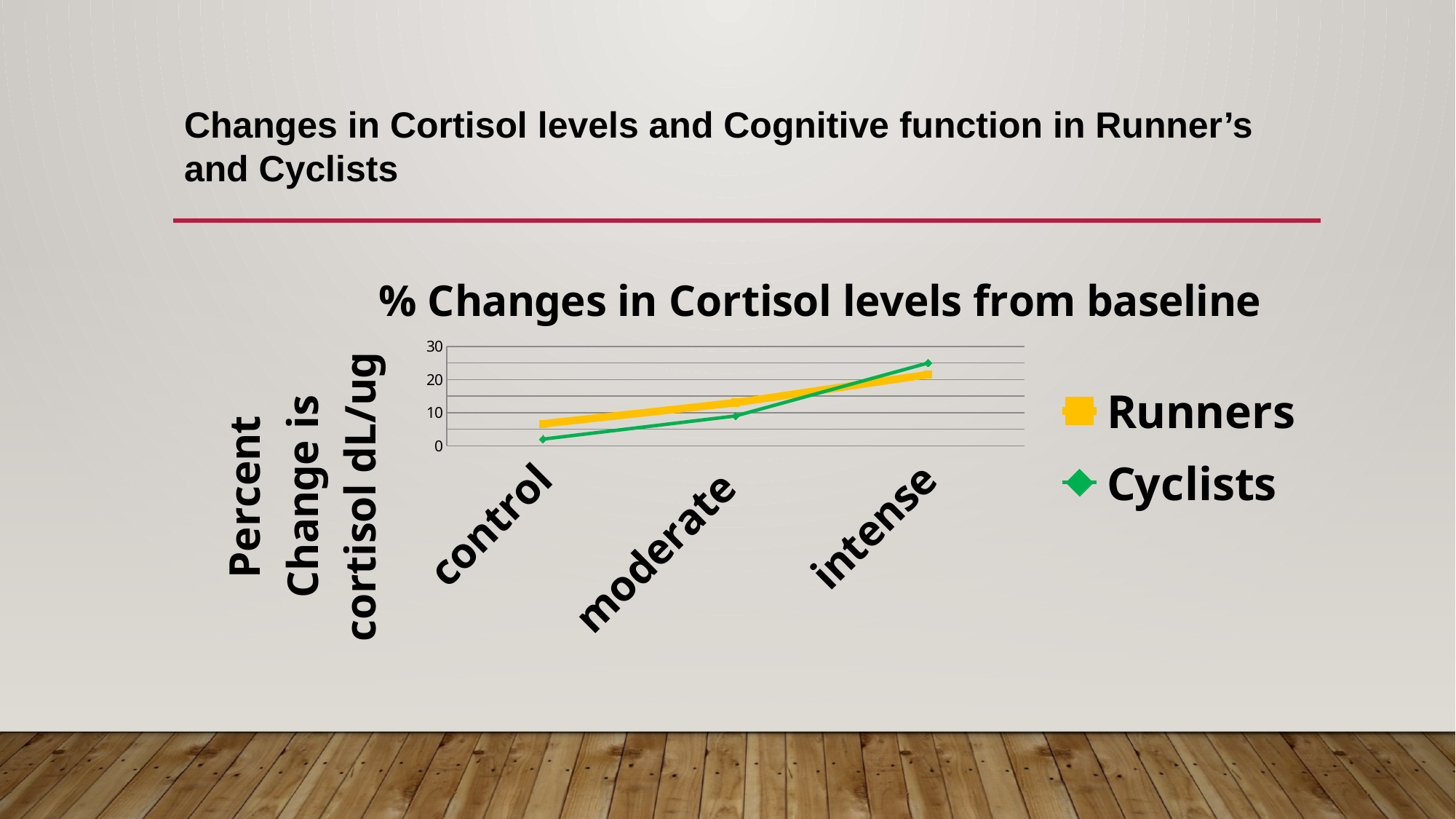
Is the Cyclists value for control greater or less than 10? less What kind of chart is shown on the slide? line chart Is the Runners value for moderate greater or less than 10? greater Which series is drawn in green? Cyclists For which category is the Cyclists value highest? intense How many series does the legend list? 2 How many categories are shown on the x axis? 3 At control, which series has the larger value, Runners or Cyclists? Runners Is the Cyclists value for intense greater or less than 20? greater Do the Cyclists values rise or fall from control to intense? rise What is the title of the chart? % Changes in Cortisol levels from baseline For which category is the Runners value lowest? control